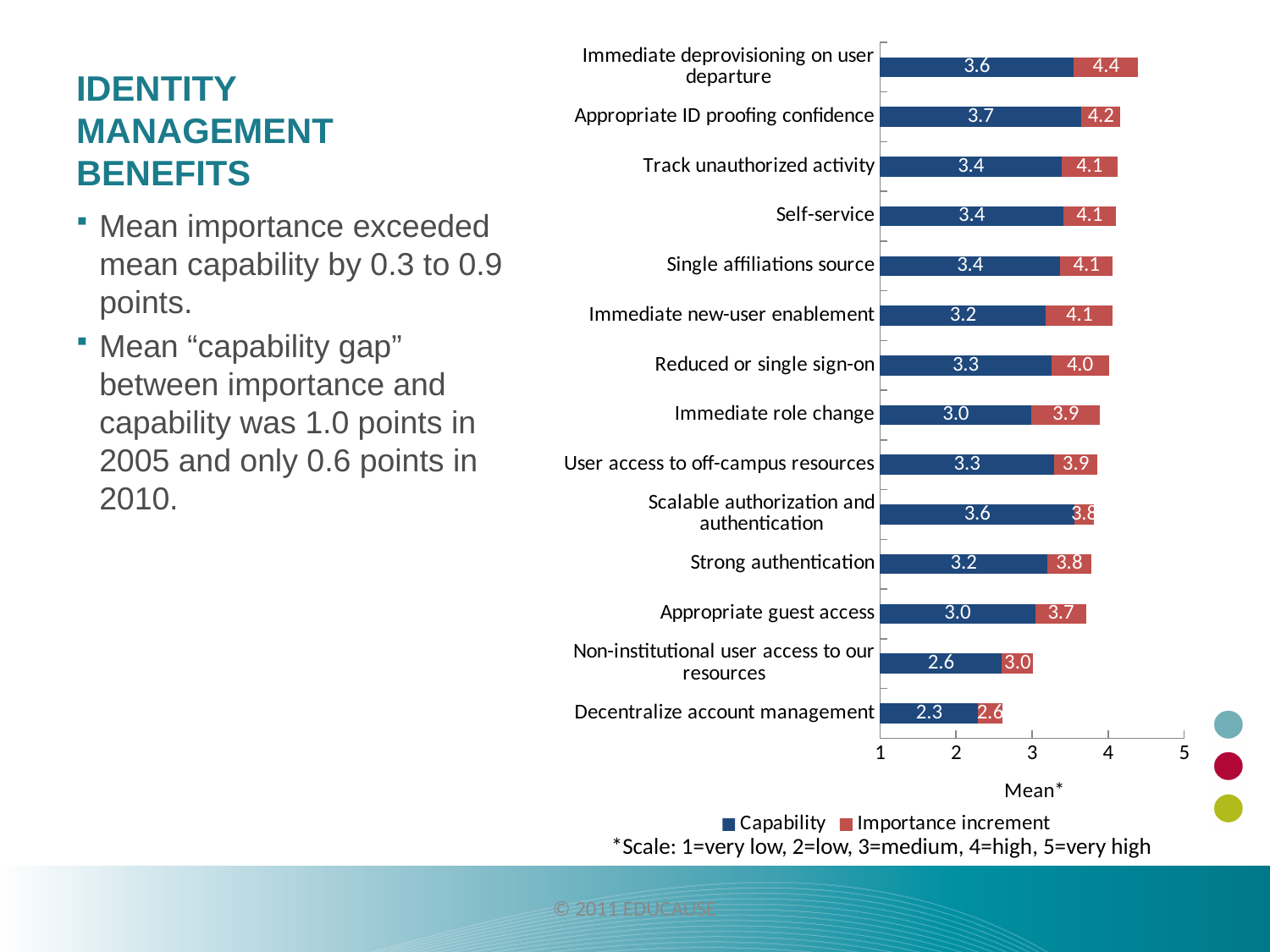
Is the Capability value for Non-institutional user access to our resources greater or less than 3? less What kind of chart is shown on the slide? Bar chart What is the Capability value for Immediate deprovisioning on user departure? 3.6 How many categories are shown on the chart? 14 What is the Capability value for Decentralize account management? 2.3 What is the difference between the value printed on the Importance increment segment (4.4) and the Capability value (3.6) for Immediate deprovisioning on user departure? 0.8 Which category has the highest Capability value? Appropriate ID proofing confidence Which has the larger Capability value, Immediate deprovisioning on user departure or Immediate role change? Immediate deprovisioning on user departure Which category has the lowest Capability value? Decentralize account management How many series does the legend list? 2 What value is printed on the Importance increment segment for Immediate deprovisioning on user departure? 4.4 What is the Capability value for Reduced or single sign-on? 3.3